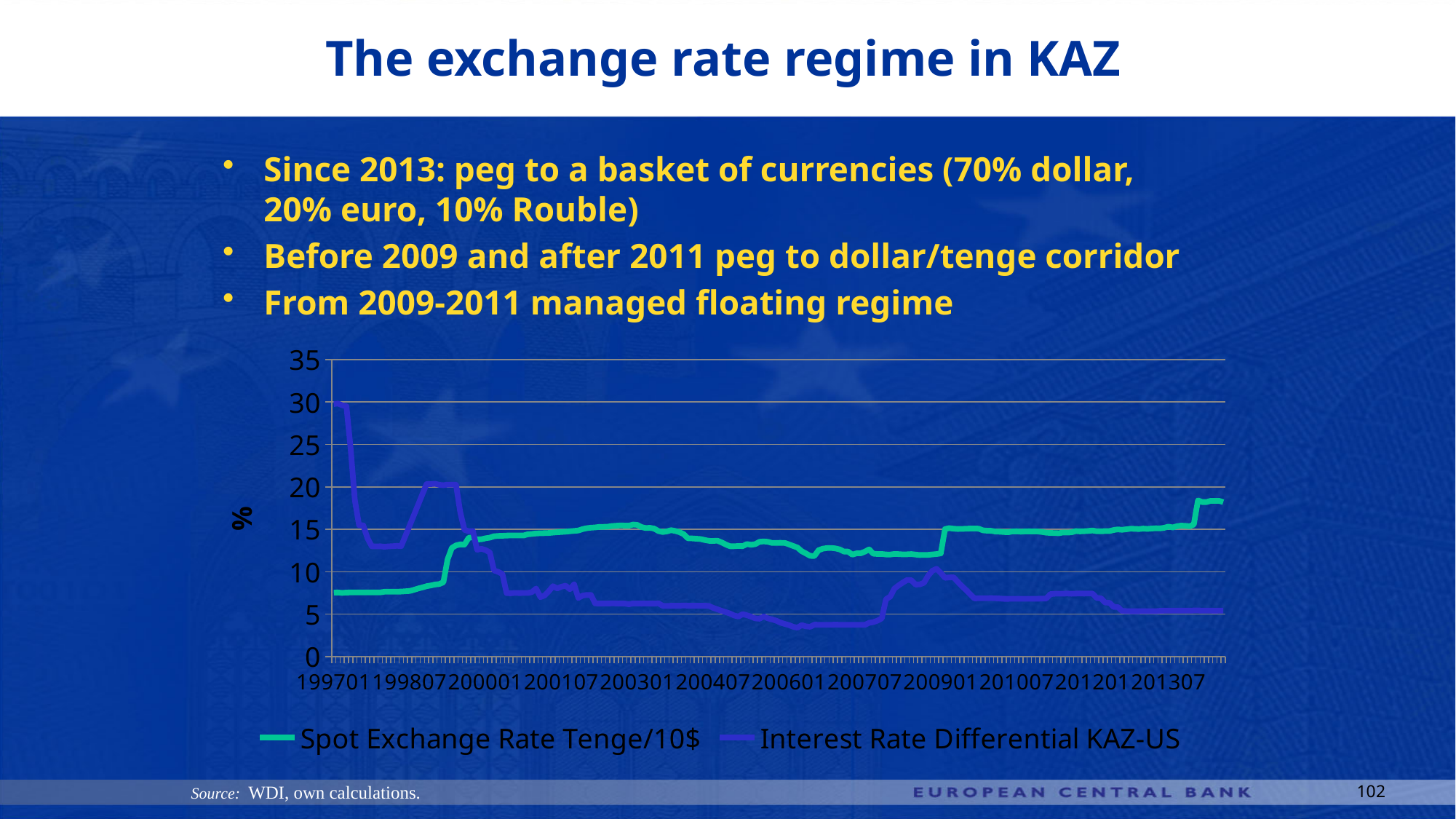
Overall, does the Interest Rate Differential KAZ-US rise or fall from the start to the end of the chart? fall Is the value of the Interest Rate Differential KAZ-US at 200301 greater or less than 10? less What is the label on the chart's vertical axis? % Is the value of the Spot Exchange Rate Tenge/10$ at the right end of the chart greater or less than 15? greater How many series does the chart's legend list? 2 Is the value of the Interest Rate Differential KAZ-US at the right end of the chart greater or less than 10? less What are the two series named in the chart's legend? Spot Exchange Rate Tenge/10$ and Interest Rate Differential KAZ-US What kind of chart is shown on the slide? Line chart At 201307, which series has the higher value: Spot Exchange Rate Tenge/10$ or Interest Rate Differential KAZ-US? Spot Exchange Rate Tenge/10$ At 199701, which series has the higher value: Spot Exchange Rate Tenge/10$ or Interest Rate Differential KAZ-US? Interest Rate Differential KAZ-US